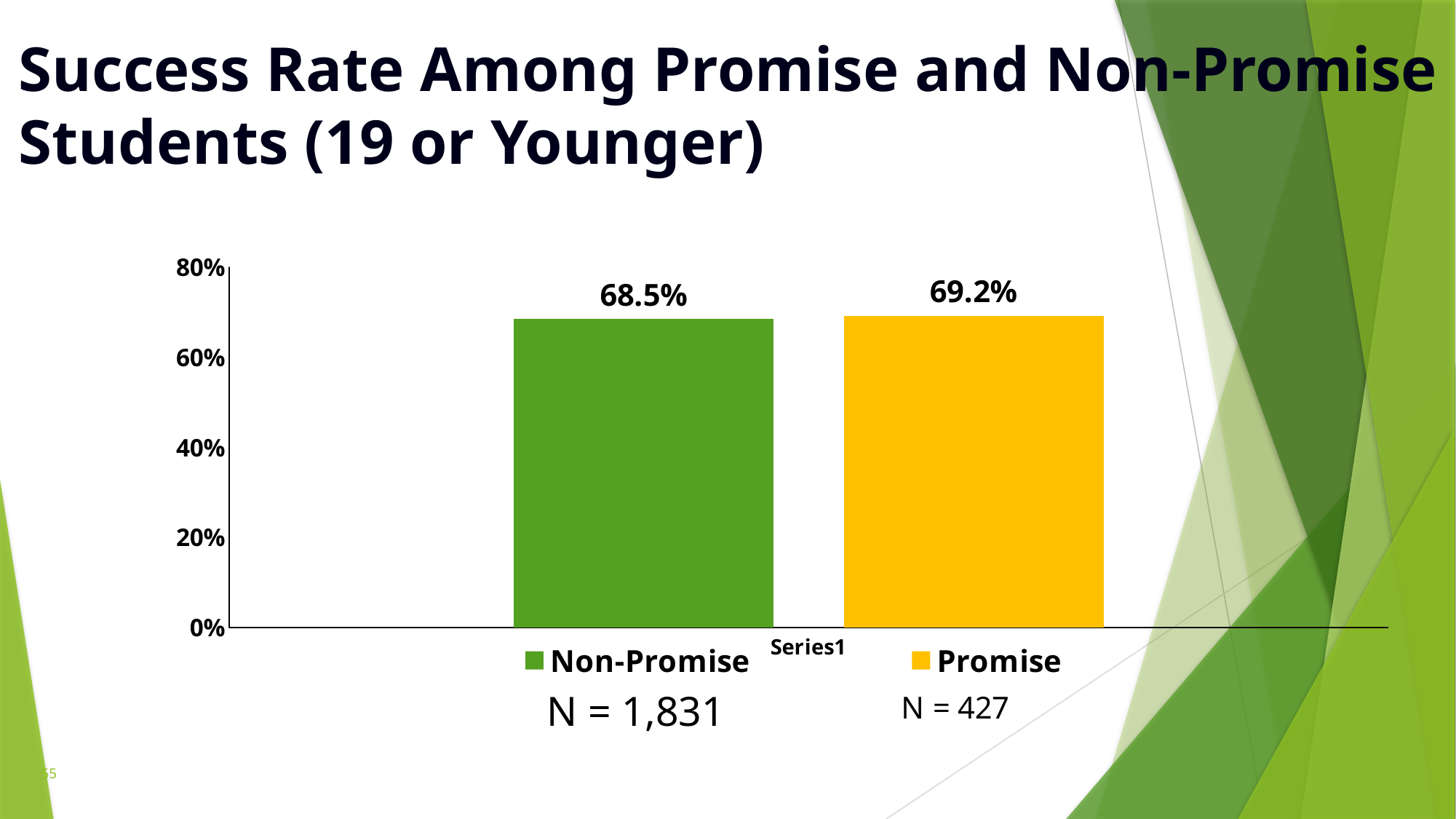
What colour is the bar for Promise students? Yellow Which group has the higher success rate, Promise or Non-Promise? Promise What is the N shown for Non-Promise students? N = 1,831 What is the success rate for Promise students? 69.2% What is the success rate for Non-Promise students? 68.5% Is the success rate for Non-Promise students greater or less than 60%? greater What kind of chart is shown on the slide? Bar chart What is the difference between the Promise and Non-Promise success rates? 0.7% How many bars are plotted on the chart? 2 Which group has the lowest success rate shown on the chart? Non-Promise How many series does the legend list? 2 Is the success rate for Promise students greater or less than 80%? less